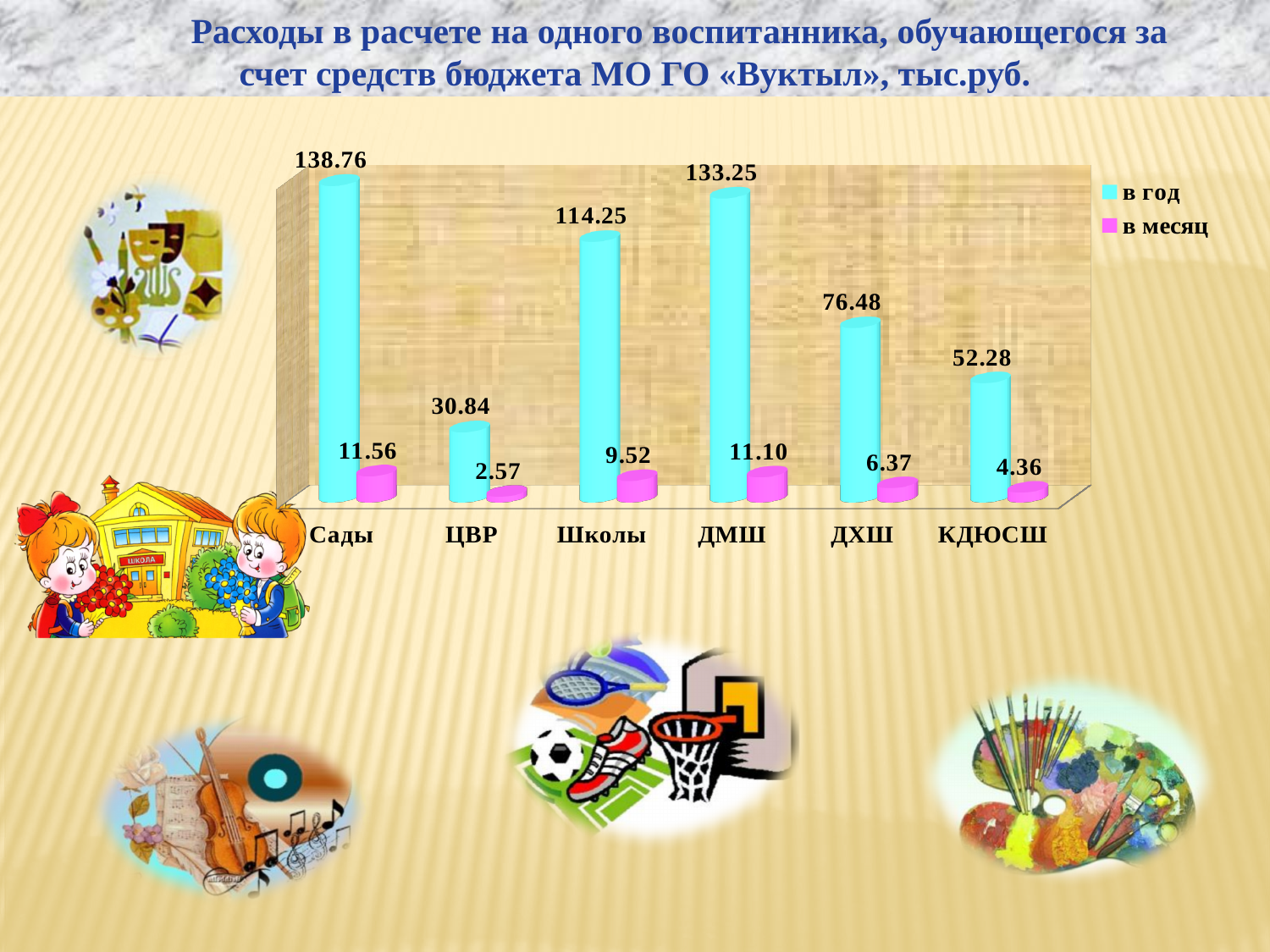
Which category has the highest "в год" value? Сады What is the value of "в месяц" for ЦВР? 2.57 How many categories are shown on the x axis? 6 What is the value of "в месяц" for КДЮСШ? 4.36 What colour are the bars for the "в месяц" series? Pink How many series does the legend list? 2 What is the difference between the "в год" values for Школы and ДМШ? 19.00 What is the value of "в год" for Сады? 138.76 What kind of chart is shown on the slide? Bar chart Which category has the lowest "в месяц" value? ЦВР What is the value of "в год" for ДХШ? 76.48 Which is larger, the "в год" value for ДХШ or for КДЮСШ? ДХШ